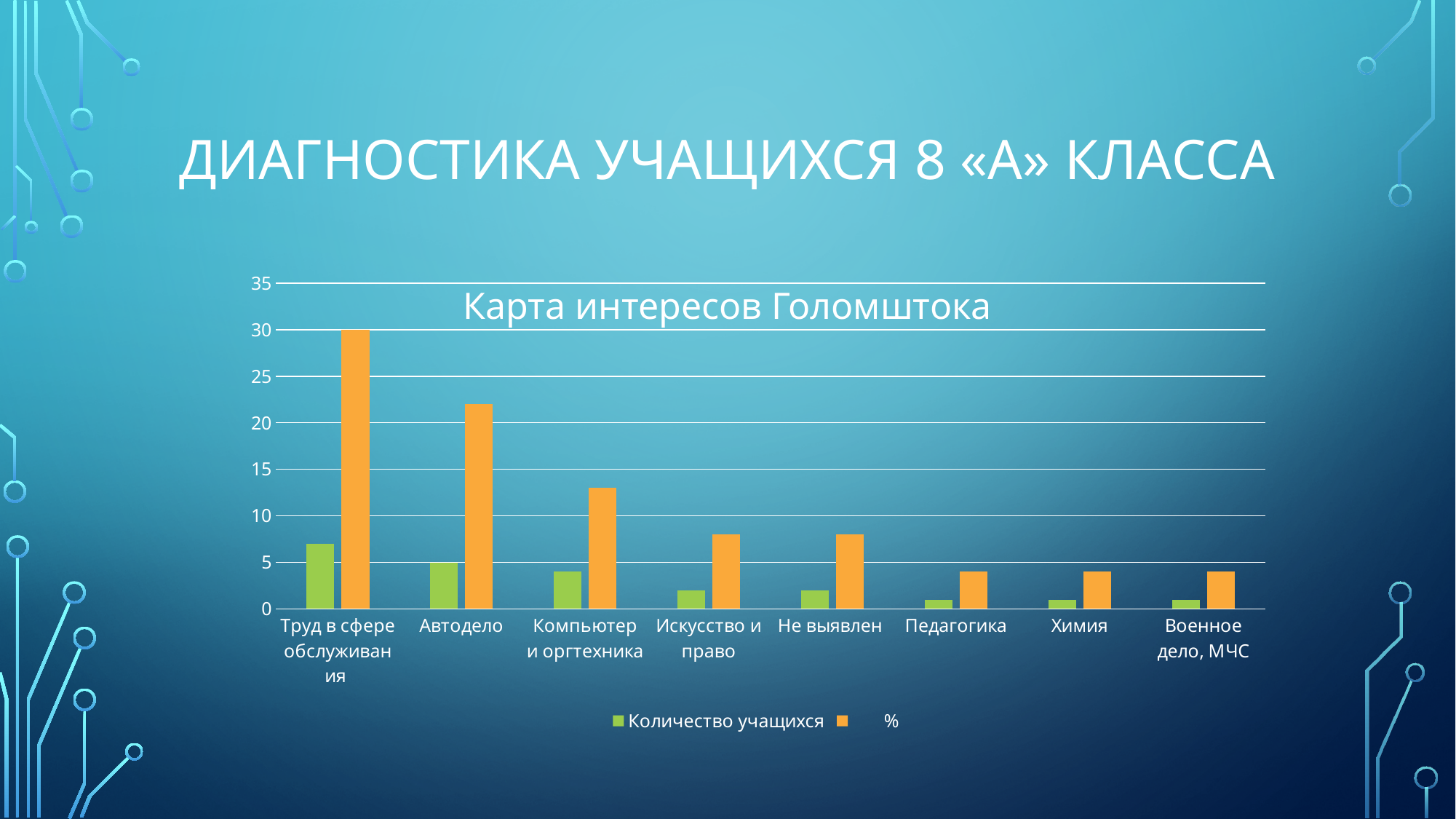
Do the % values rise or fall from left to right across the categories? fall Is the % value for Автодело greater or less than 20? greater How many series does the legend list? 2 What type of chart is shown on the slide? bar chart What is the Количество учащихся value for Автодело? 5 What is the title of the chart? Карта интересов Голомштока Which category has the highest value for Количество учащихся? Труд в сфере обслуживания What is the % value for Труд в сфере обслуживания? 30 Which category has the highest value for the % series? Труд в сфере обслуживания How many categories are shown on the x axis? 8 Is the % value for Компьютер и оргтехника greater or less than 15? less Which is larger, the % value for Автодело or the % value for Компьютер и оргтехника? Автодело